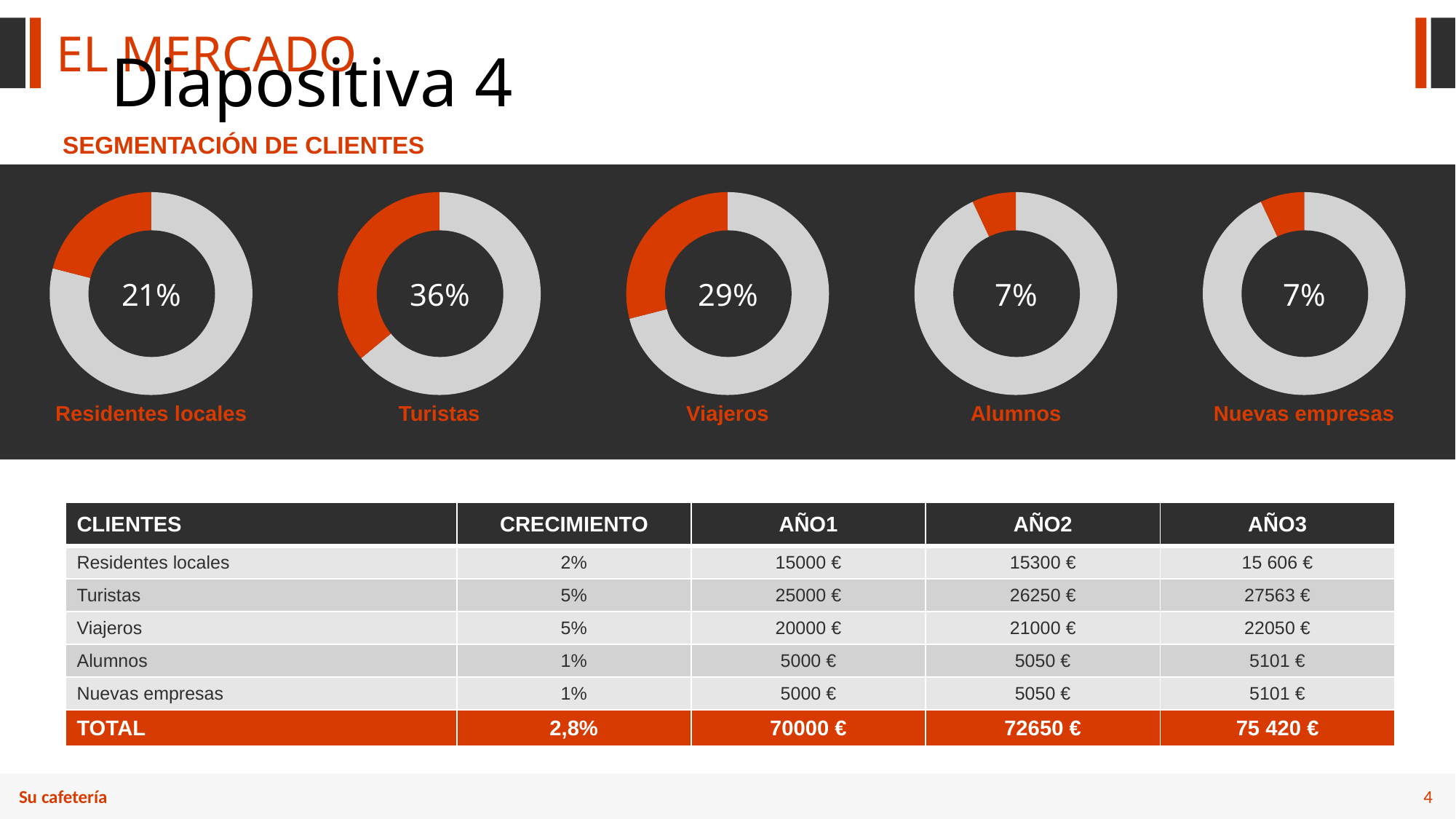
What type of chart is used to show the customer segmentation percentages? Donut chart What percentage is shown in the Alumnos donut chart? 7% What percentage is shown in the Residentes locales donut chart? 21% Which is larger, the percentage for Residentes locales or for Viajeros? Viajeros What is the difference in percentage points between the Turistas and Viajeros donut charts? 7 What percentage is shown in the Nuevas empresas donut chart? 7% What colour is the highlighted segment in each donut chart? Orange Which customer segment has the highest percentage among the donut charts? Turistas What percentage is shown in the Turistas donut chart? 36% What percentage is shown in the Viajeros donut chart? 29% Which two customer segments share the lowest percentage among the donut charts? Alumnos and Nuevas empresas How many donut charts are shown on the slide? 5